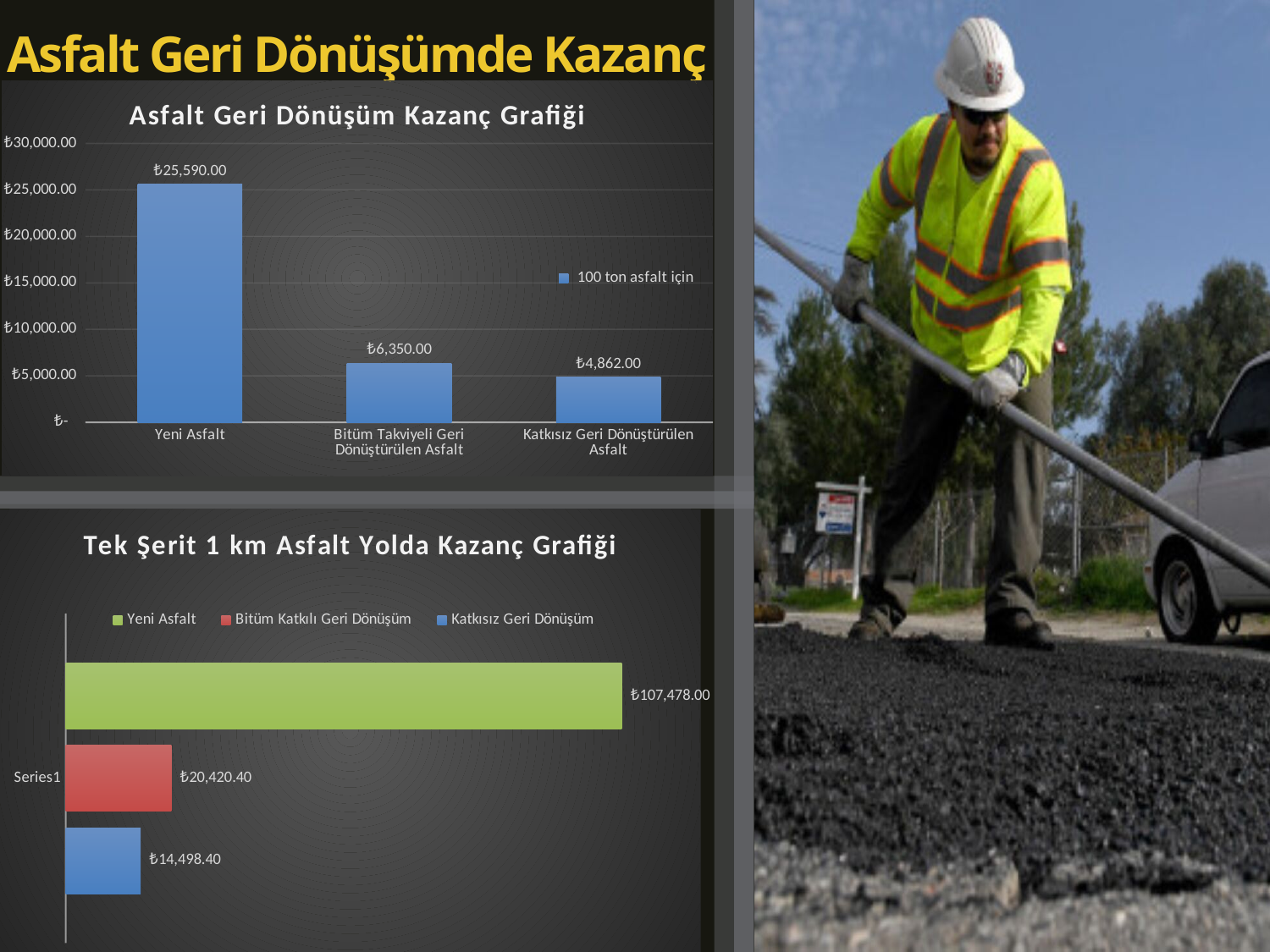
In the chart titled "Asfalt Geri Dönüşüm Kazanç Grafiği", how many categories are shown? 3 What kind of chart is the one titled "Tek Şerit 1 km Asfalt Yolda Kazanç Grafiği"? Bar chart In the chart titled "Tek Şerit 1 km Asfalt Yolda Kazanç Grafiği", which series has the highest value? Yeni Asfalt In the chart titled "Asfalt Geri Dönüşüm Kazanç Grafiği", what is the value for Bitüm Takviyeli Geri Dönüştürülen Asfalt? ₺6,350.00 In the chart titled "Tek Şerit 1 km Asfalt Yolda Kazanç Grafiği", what is the value for Yeni Asfalt? ₺107,478.00 In the chart titled "Tek Şerit 1 km Asfalt Yolda Kazanç Grafiği", what is the difference between Bitüm Katkılı Geri Dönüşüm and Katkısız Geri Dönüşüm? ₺5,922.00 In the chart titled "Asfalt Geri Dönüşüm Kazanç Grafiği", what is the difference between Yeni Asfalt and Bitüm Takviyeli Geri Dönüştürülen Asfalt? ₺19,240.00 In the chart titled "Tek Şerit 1 km Asfalt Yolda Kazanç Grafiği", what is the value for Katkısız Geri Dönüşüm? ₺14,498.40 In the chart titled "Asfalt Geri Dönüşüm Kazanç Grafiği", which category has the lowest value? Katkısız Geri Dönüştürülen Asfalt In the chart titled "Tek Şerit 1 km Asfalt Yolda Kazanç Grafiği", how many series does the legend list? 3 In the chart titled "Asfalt Geri Dönüşüm Kazanç Grafiği", what is the legend entry? 100 ton asfalt için In the chart titled "Asfalt Geri Dönüşüm Kazanç Grafiği", what is the value for Yeni Asfalt? ₺25,590.00